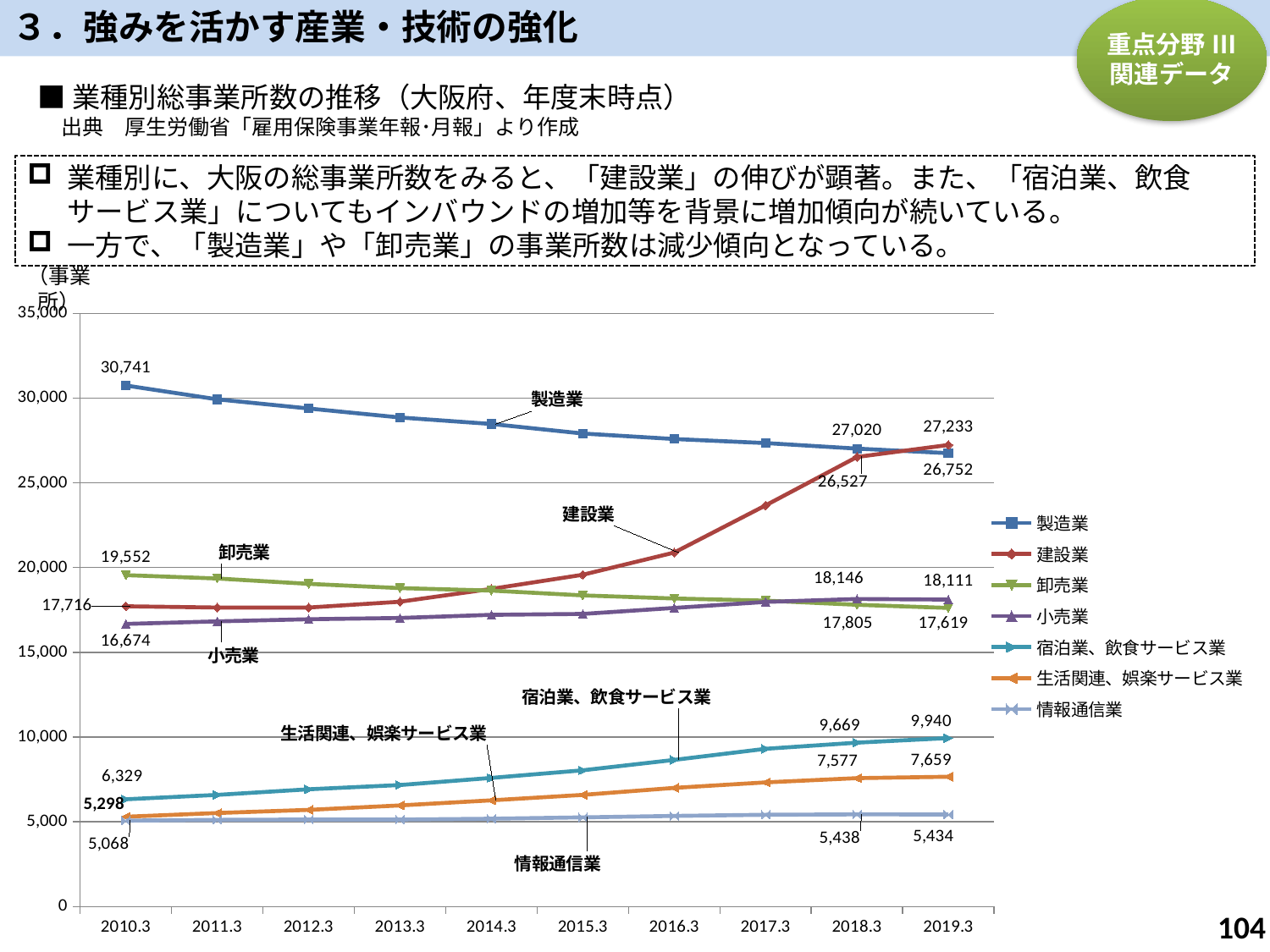
Which series has the lowest value at 2010.3? 情報通信業 What is the value for 建設業 at 2019.3? 27,233 What is the value for 情報通信業 at 2010.3? 5,068 Which series has the highest value at 2019.3? 建設業 Is the value for 建設業 at 2016.3 greater or less than 20,000? greater What is the value for 製造業 at 2010.3? 30,741 What is the difference between the 製造業 values at 2010.3 and 2019.3? 3,989 What type of chart is shown on the slide? line chart What is the value for 宿泊業、飲食サービス業 at 2018.3? 9,669 Does the 製造業 series rise or fall from 2010.3 to 2019.3? fall How many time points are shown on the x axis? 10 How many series does the legend list? 7